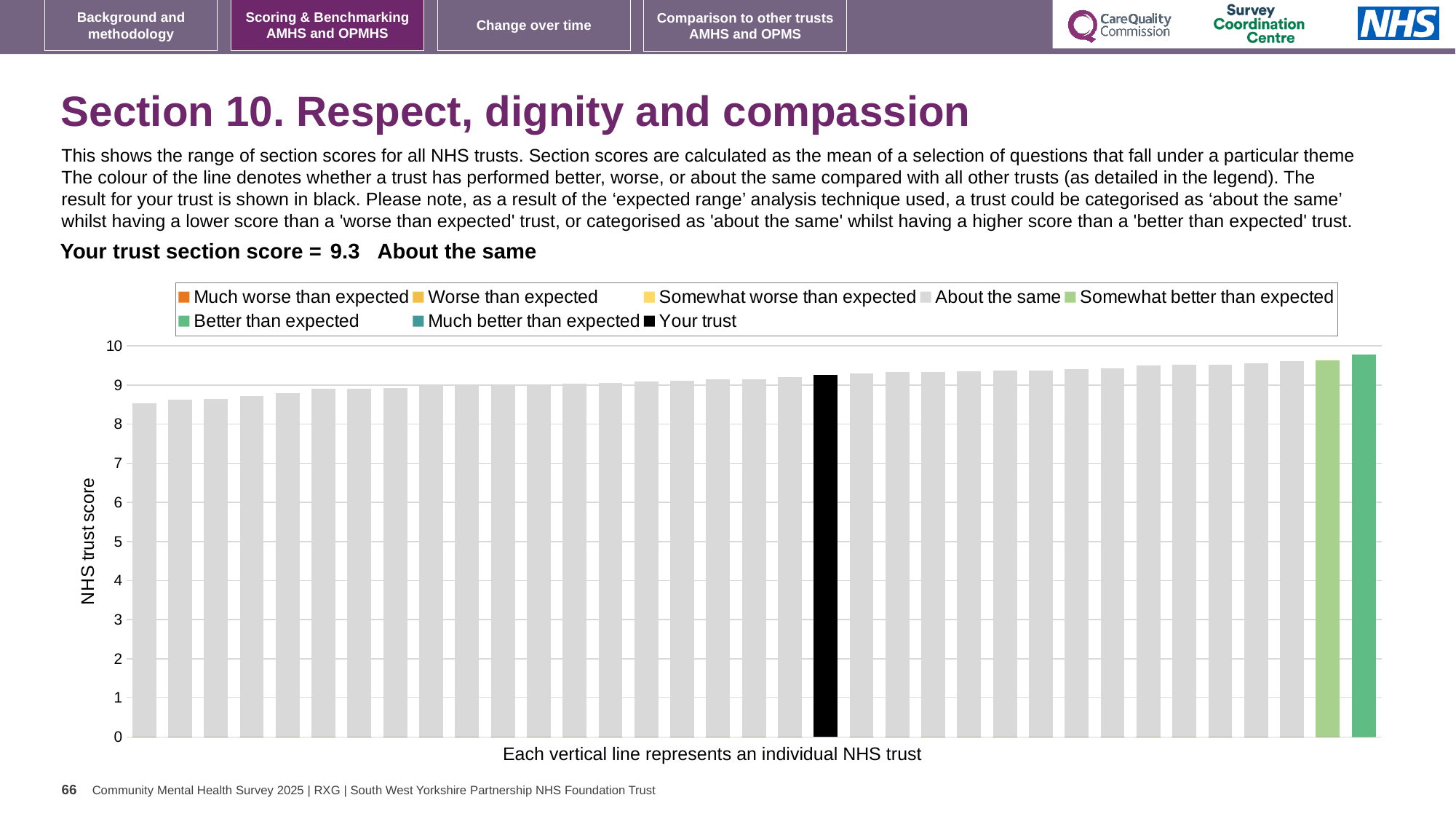
Which legend category does the highest bar belong to? Better than expected Is the value of the rightmost bar greater or less than 9? greater Is the value of the black 'Your trust' bar greater or less than 9? greater Is the value of the leftmost bar greater or less than 9? less Do the bar values rise or fall from left to right along the x axis? rise Which is larger, the rightmost bar or the leftmost bar? the rightmost bar What is the label on the vertical axis of the chart? NHS trust score How many entries does the chart legend list? 8 What kind of chart is shown on the slide? bar chart What colour is the bar representing your trust? black Which legend category does the lowest bar belong to? About the same What is the section score for your trust? 9.3